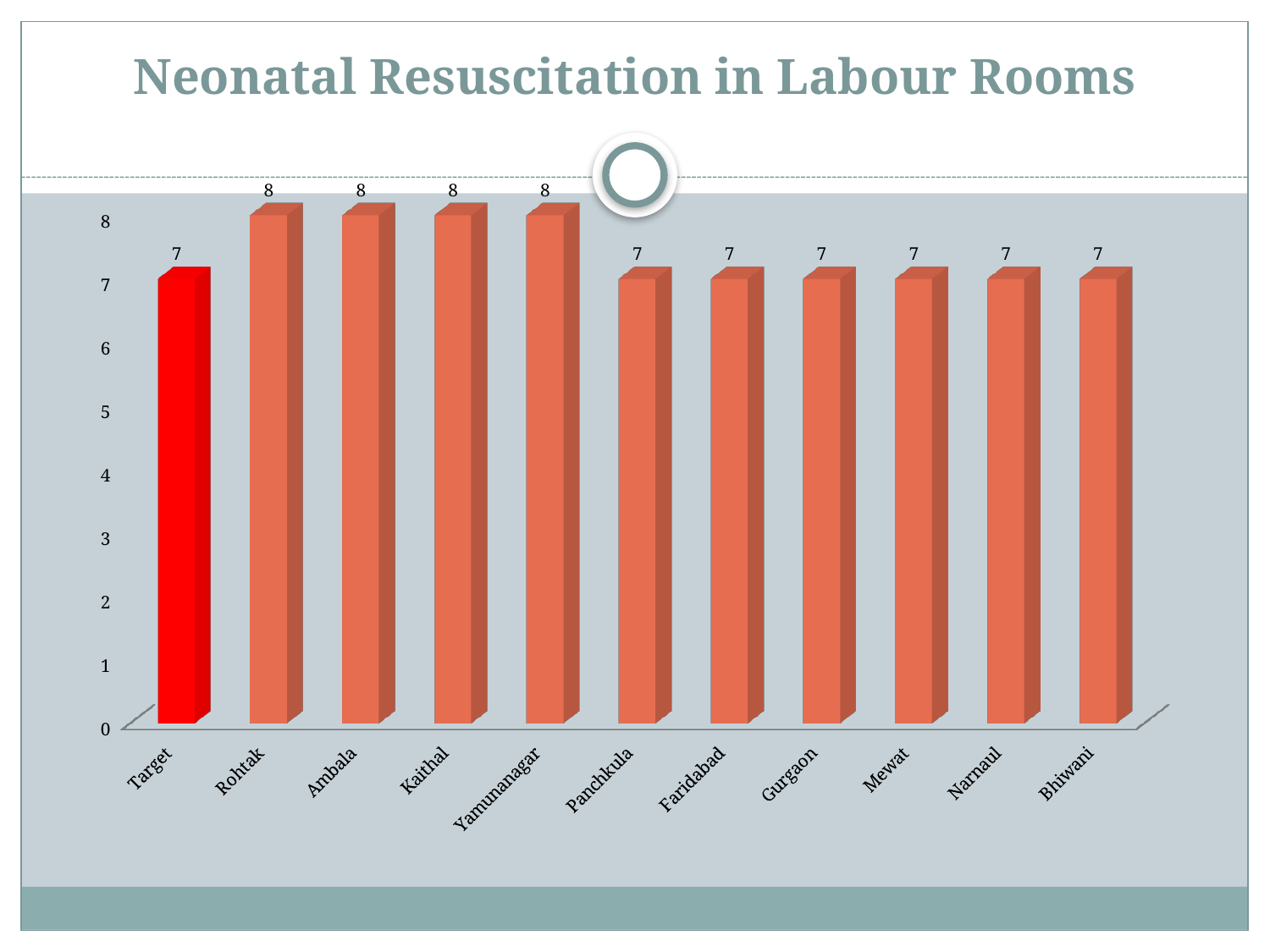
What is the title of the chart? Neonatal Resuscitation in Labour Rooms What is the value for Bhiwani? 7 What is the value for Panchkula? 7 What is the value for Yamunanagar? 8 Which bar is coloured differently from the others? Target What is the value for Rohtak? 8 Which is larger, the value for Kaithal or the value for Mewat? Kaithal How many categories are shown on the x axis? 11 What is the difference between the values for Ambala and Target? 1 What is the value for Target? 7 What kind of chart is shown on the slide? bar chart Is the value for Gurgaon greater or less than 5? greater